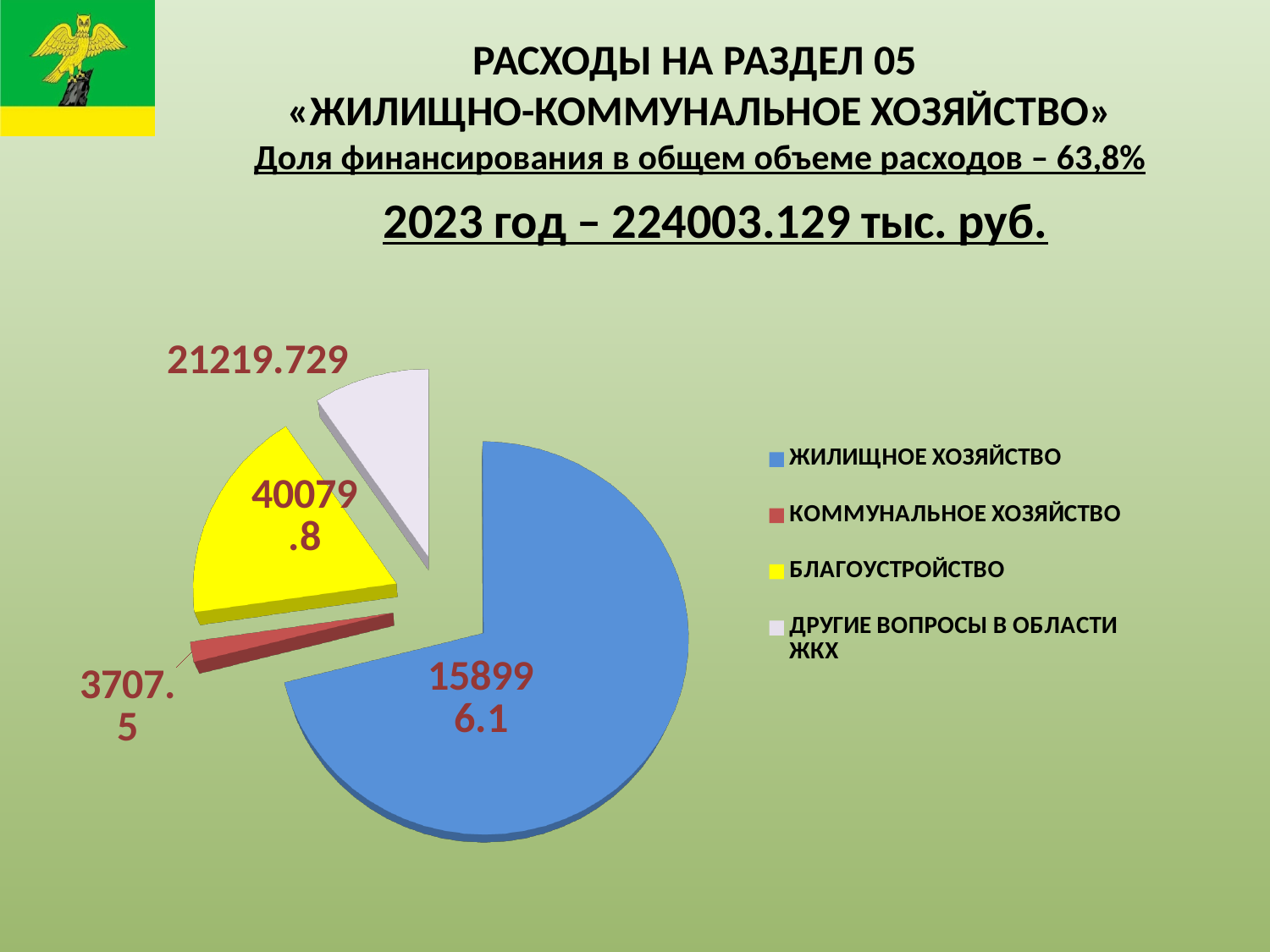
What is the value for ЖИЛИЩНОЕ ХОЗЯЙСТВО in the pie chart? 158996.1 What is the value for КОММУНАЛЬНОЕ ХОЗЯЙСТВО in the pie chart? 3707.5 What kind of chart is shown on the slide? Pie chart Which is larger, БЛАГОУСТРОЙСТВО or ДРУГИЕ ВОПРОСЫ В ОБЛАСТИ ЖКХ? БЛАГОУСТРОЙСТВО How many slices does the pie chart have? 4 What is the difference between the values for БЛАГОУСТРОЙСТВО and ДРУГИЕ ВОПРОСЫ В ОБЛАСТИ ЖКХ? 18860.071 Which category has the largest slice in the pie chart? ЖИЛИЩНОЕ ХОЗЯЙСТВО Which category has the smallest slice in the pie chart? КОММУНАЛЬНОЕ ХОЗЯЙСТВО What is the value for ДРУГИЕ ВОПРОСЫ В ОБЛАСТИ ЖКХ in the pie chart? 21219.729 What is the value for БЛАГОУСТРОЙСТВО in the pie chart? 40079.8 How many entries does the legend list? 4 Which colour represents БЛАГОУСТРОЙСТВО in the pie chart? Yellow